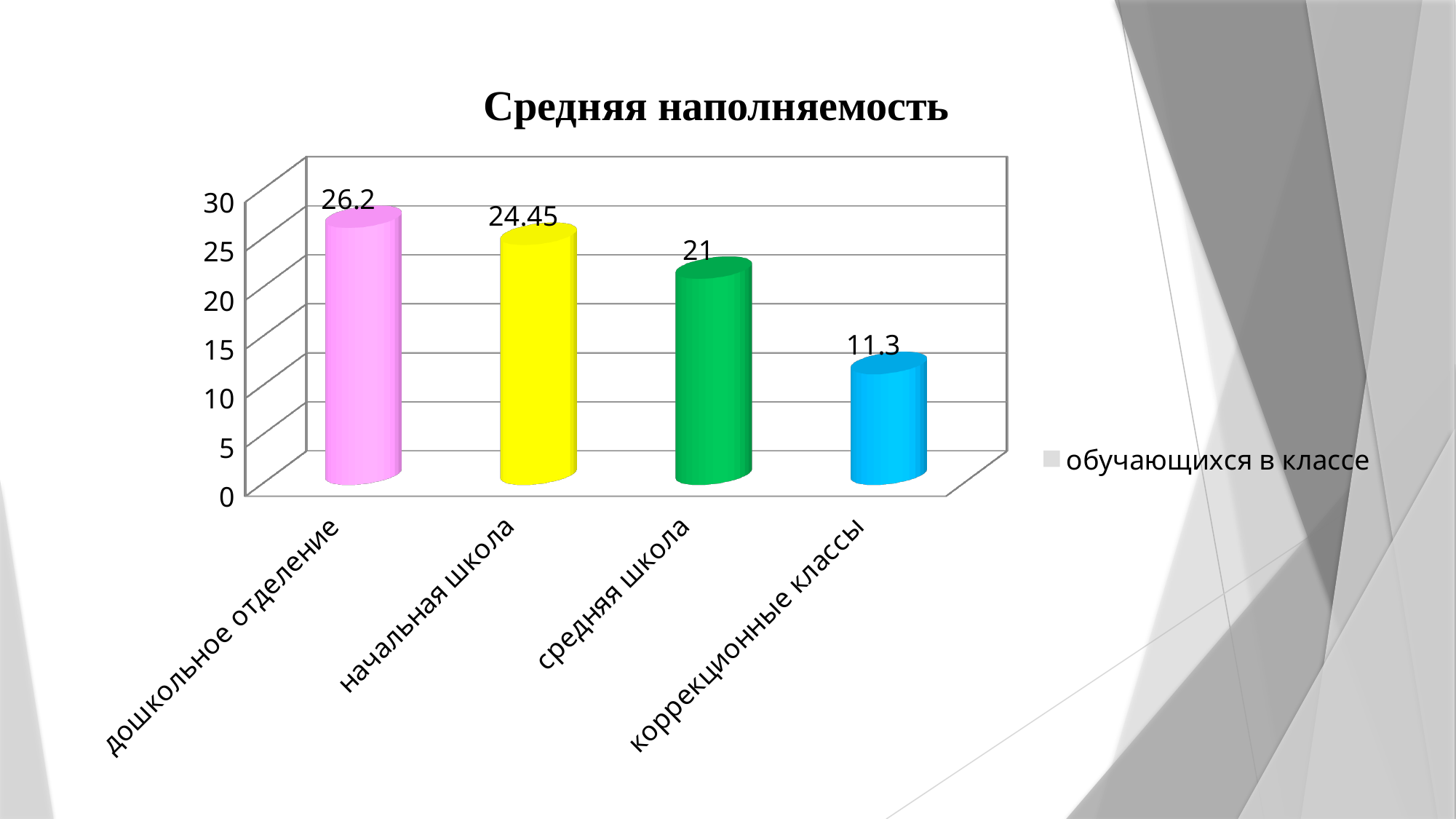
What is the difference between the values for начальная школа and средняя школа? 3.45 What is the value for средняя школа? 21 What is the title of the chart? Средняя наполняемость Which is larger, the value for начальная школа or the value for средняя школа? начальная школа Which category has the lowest value? коррекционные классы What kind of chart is this? bar chart What is the difference between the values for дошкольное отделение and коррекционные классы? 14.9 What is the value for начальная школа? 24.45 What is the value for дошкольное отделение? 26.2 Which category has the highest value? дошкольное отделение How many categories are shown in the chart? 4 What is the value for коррекционные классы? 11.3